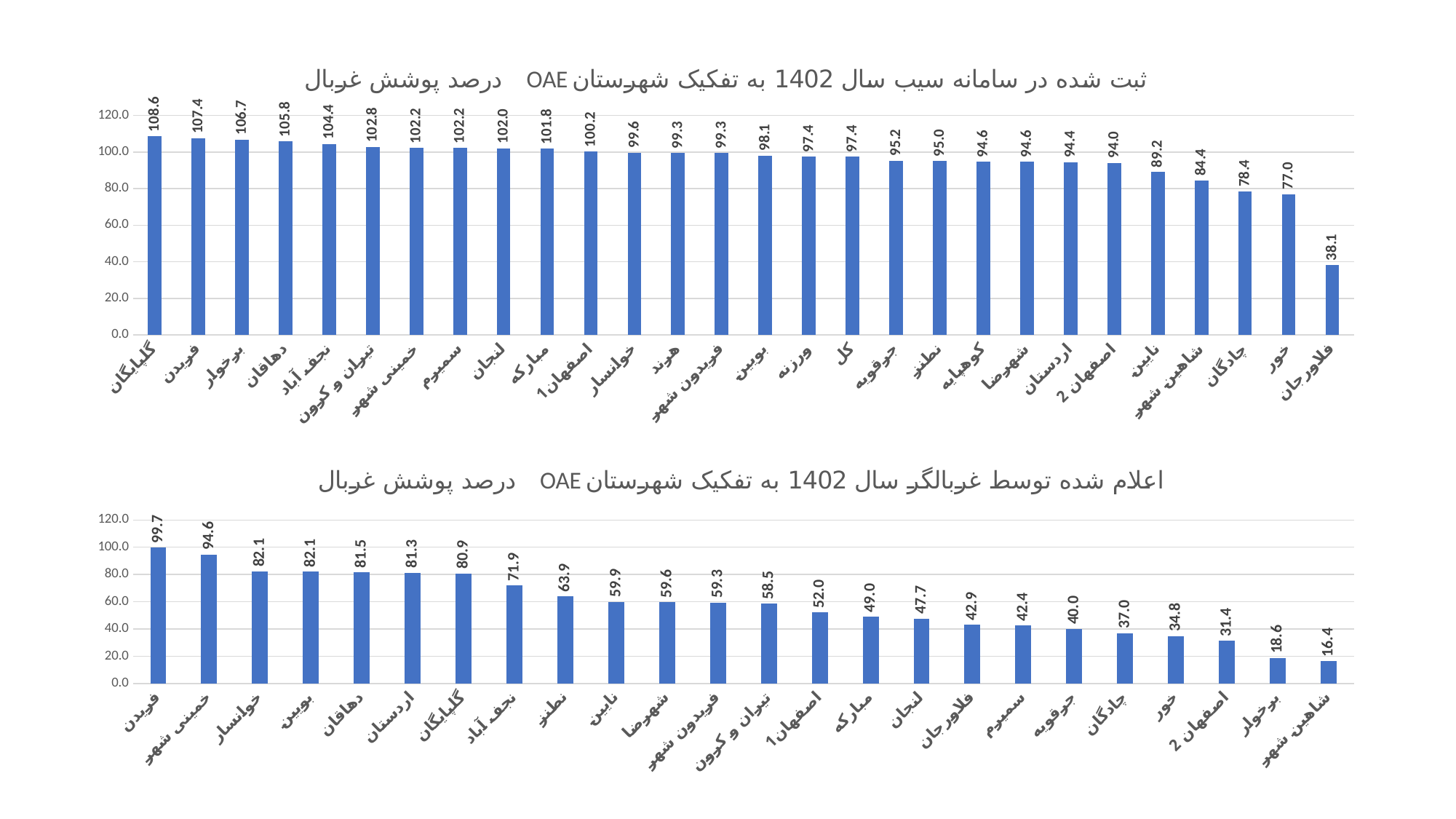
In the bottom chart, what is the difference between the values for فریدن and خمینی شهر? 5.1 In the top chart, which category has the highest value? گلپایگان In the top chart, how many categories are plotted? 28 In the bottom chart, which is larger, the value for نطنز or the value for نایین? نطنز In the bottom chart, how many categories are plotted? 24 In the bottom chart, do the values rise or fall from left to right along the x axis? fall In the top chart, is the value for نایین greater or less than 100.0? less In the bottom chart, which category has the lowest value? شاهین شهر In the top chart, what is the value for فلاورجان? 38.1 In the top chart, what is the difference between the values for گلپایگان and فریدن? 1.2 In the bottom chart, what is the value for فریدن? 99.7 What kind of chart is the bottom chart? bar chart